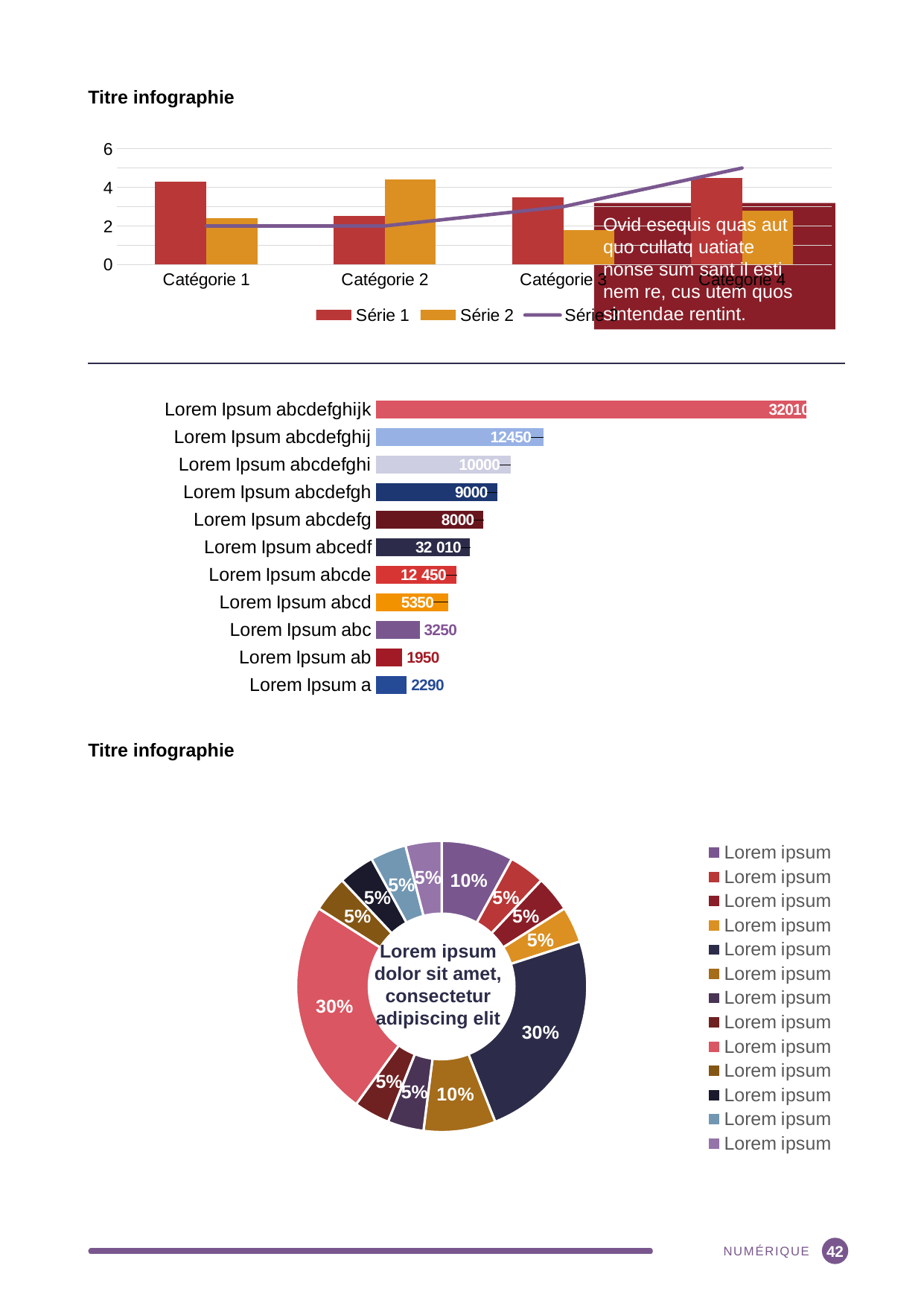
In the middle horizontal bar chart, which category has the lowest value? Lorem Ipsum ab In the top chart, is the value of Série 2 for Catégorie 2 greater or less than 4? greater In the bottom doughnut chart, what share do the two largest slices each have? 30% In the middle horizontal bar chart, how many categories are shown? 11 What kind of chart is the top chart titled 'Titre infographie'? A combined bar and line chart In the middle horizontal bar chart, which category has the highest value? Lorem Ipsum abcdefghijk In the middle horizontal bar chart, what is the difference between the values for Lorem Ipsum abcdefghij and Lorem Ipsum abcdefghi? 2450 In the middle horizontal bar chart, what is the value for Lorem Ipsum abcd? 5350 In the top chart, is the value of Série 1 for Catégorie 2 greater or less than 2? greater In the bottom doughnut chart, how many slices are there? 13 In the top chart, does the Série 3 line rise or fall from Catégorie 2 to Catégorie 4? It rises In the top chart, how many series does the legend list? 3